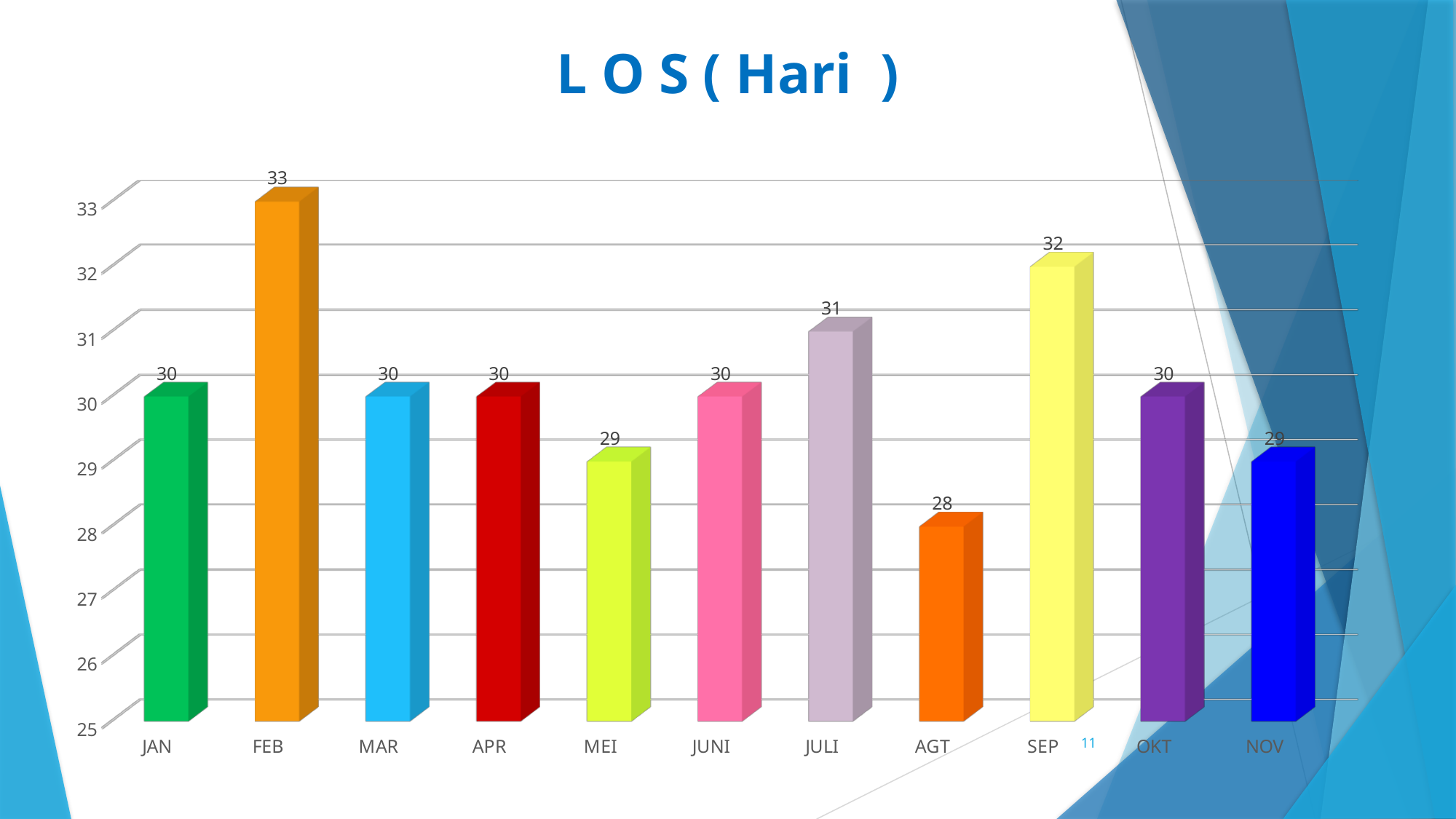
What is the title of the chart? L O S ( Hari ) What is the value for SEP? 32 What is the value for JULI? 31 What kind of chart is shown on the slide? bar chart Which is larger, the value for JULI or the value for MEI? JULI What is the value for AGT? 28 What is the value for FEB? 33 What is the difference between the values for SEP and NOV? 3 Which month has the lowest value? AGT What is the difference between the values for FEB and AGT? 5 How many months are shown on the x axis? 11 Which month has the highest value? FEB